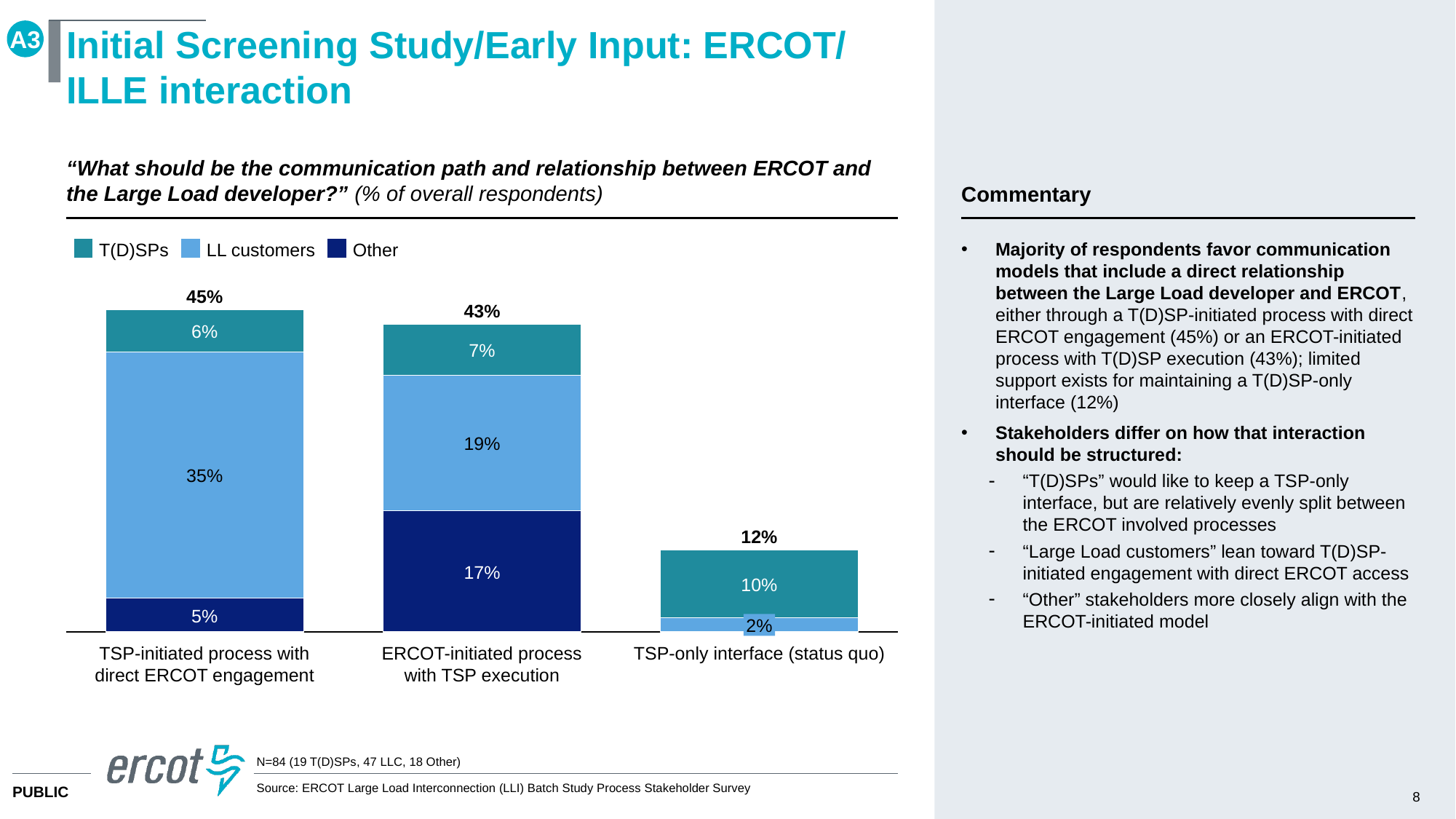
What is the LL customers value for 'TSP-initiated process with direct ERCOT engagement'? 35% Which is larger: the Other value for 'TSP-initiated process with direct ERCOT engagement' or the Other value for 'ERCOT-initiated process with TSP execution'? ERCOT-initiated process with TSP execution What is the difference between the LL customers values for 'TSP-initiated process with direct ERCOT engagement' and 'ERCOT-initiated process with TSP execution'? 16% What is the total for the 'ERCOT-initiated process with TSP execution' bar? 43% What is the total for the 'TSP-initiated process with direct ERCOT engagement' bar? 45% What is the T(D)SPs value for 'TSP-only interface (status quo)'? 10% How many series does the legend list? 3 What is the Other value for 'ERCOT-initiated process with TSP execution'? 17% How many categories (bars) are shown in the chart? 3 Which category has the highest total? TSP-initiated process with direct ERCOT engagement Which category has the lowest total? TSP-only interface (status quo) What kind of chart is shown on the slide? Stacked bar chart